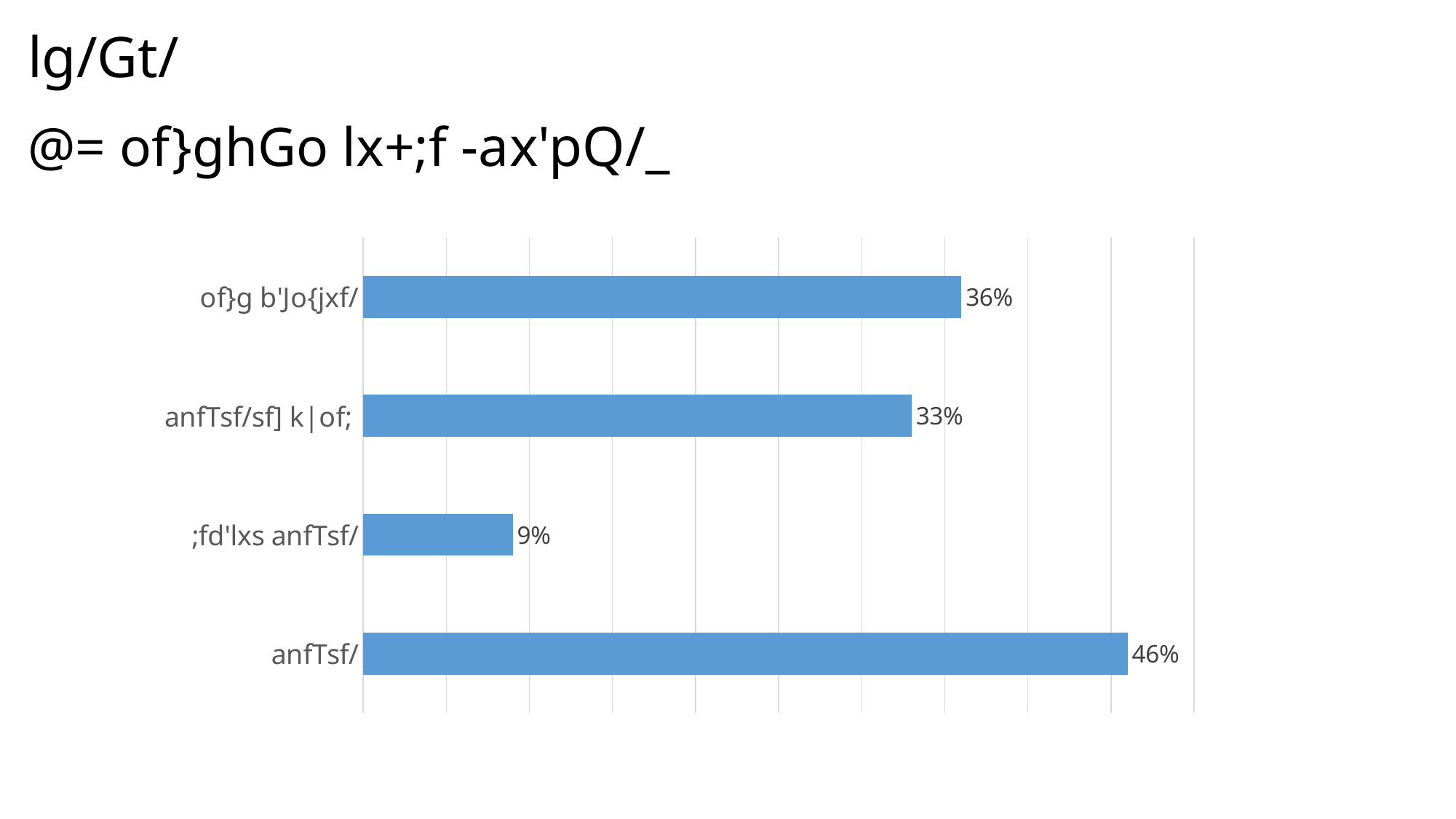
What kind of chart is shown on the slide? bar chart What is the value for the category ";fd'lxs anfTsf/"? 9% What is the difference between the values for "of}g b'Jo{jxf/" and "anfTsf/sf] k|of;"? 3% What colour are the bars in the chart? blue Which category has the lowest value? ;fd'lxs anfTsf/ What is the value for the category "of}g b'Jo{jxf/"? 36% What is the difference between the values for "anfTsf/" and ";fd'lxs anfTsf/"? 37% Which is larger, the value for "anfTsf/" or the value for "of}g b'Jo{jxf/"? anfTsf/ How many categories are shown in the chart? 4 Which category has the highest value? anfTsf/ What is the value for the category "anfTsf/sf] k|of;"? 33% What is the value for the category "anfTsf/"? 46%